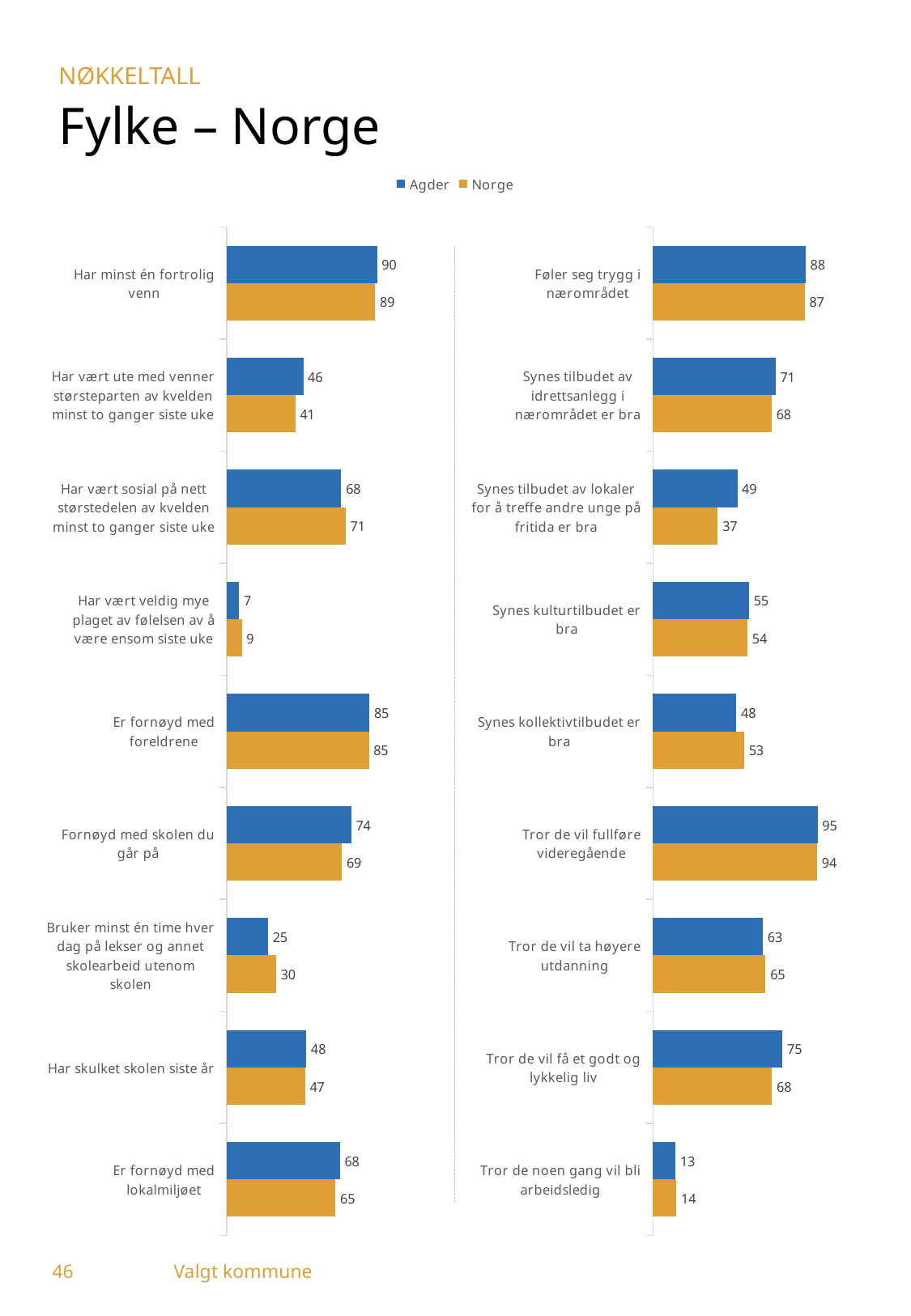
On the left chart, what is the Agder value for "Har minst én fortrolig venn"? 90 How many categories are shown on the left chart? 9 Which colour represents Norge in the legend? Orange On the left chart, which is larger for "Bruker minst én time hver dag på lekser og annet skolearbeid utenom skolen": Agder or Norge? Norge How many series does the legend list? 2 On the left chart, which category has the lowest Agder value? Har vært veldig mye plaget av følelsen av å være ensom siste uke On the left chart, what is the difference between the Agder and Norge values for "Fornøyd med skolen du går på"? 5 On the right chart, what is the difference between the Agder and Norge values for "Tror de vil få et godt og lykkelig liv"? 7 On the right chart, what is the Norge value for "Synes tilbudet av lokaler for å treffe andre unge på fritida er bra"? 37 What kind of chart is used on the slide? Bar chart On the right chart, which is larger for "Synes kollektivtilbudet er bra": Agder or Norge? Norge On the right chart, which category has the highest Agder value? Tror de vil fullføre videregående